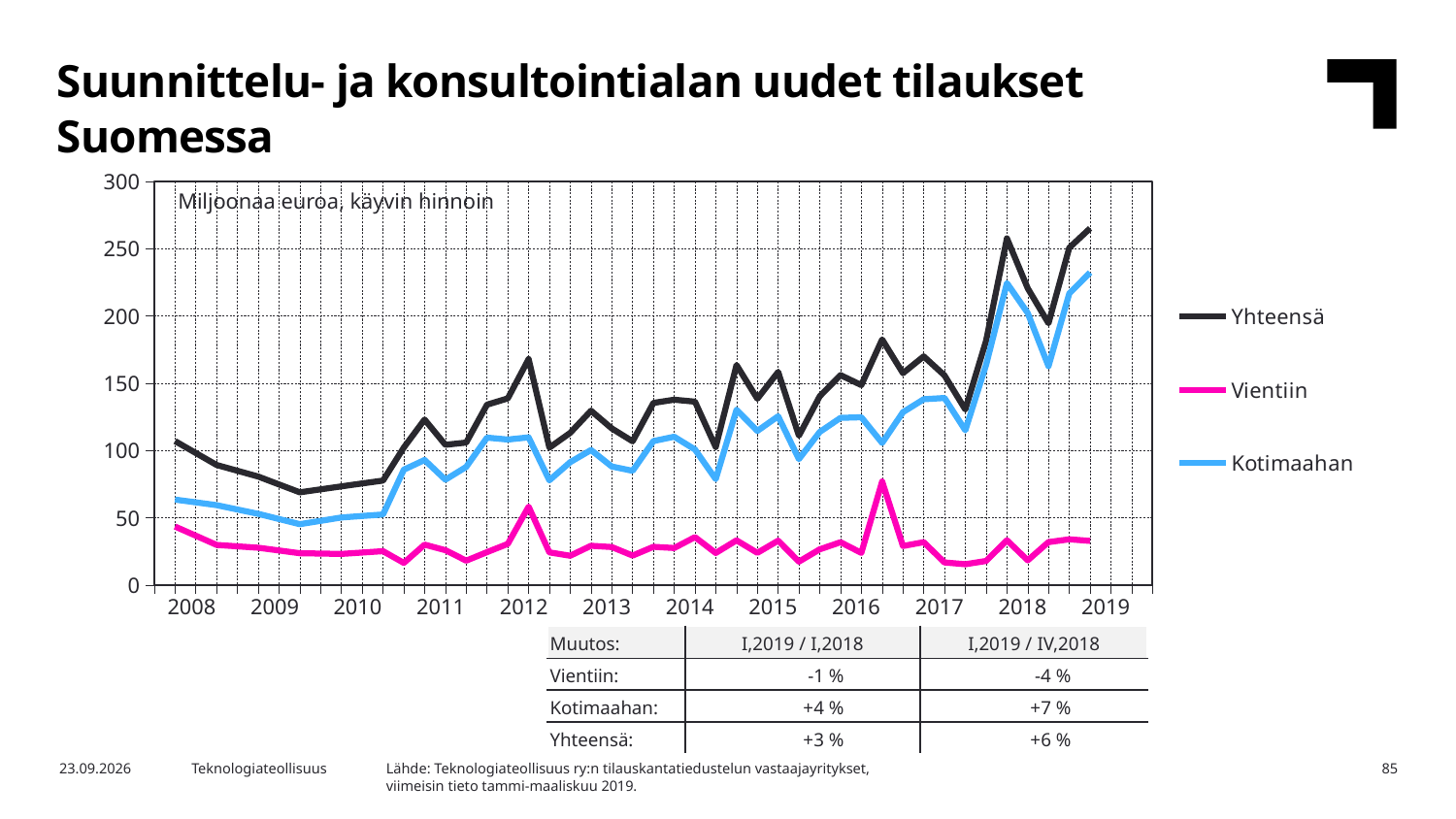
Which series are listed in the chart legend? Yhteensä, Vientiin, Kotimaahan How many series does the chart legend list? 3 What unit is stated in the text box inside the chart? Miljoonaa euroa, käyvin hinnoin How many years are labelled on the x axis of the chart? 12 Is the peak value for Vientiin in 2016 greater or less than 100? less Which series has the lowest values throughout the chart? Vientiin Is the value for Yhteensä at the last point in 2019 greater or less than 250? greater At the last point in 2019, which is larger, Kotimaahan or Vientiin? Kotimaahan Does the Yhteensä series overall rise or fall from 2008 to 2019? rise What kind of chart is shown on the slide? line chart Which series has the highest values throughout the chart? Yhteensä